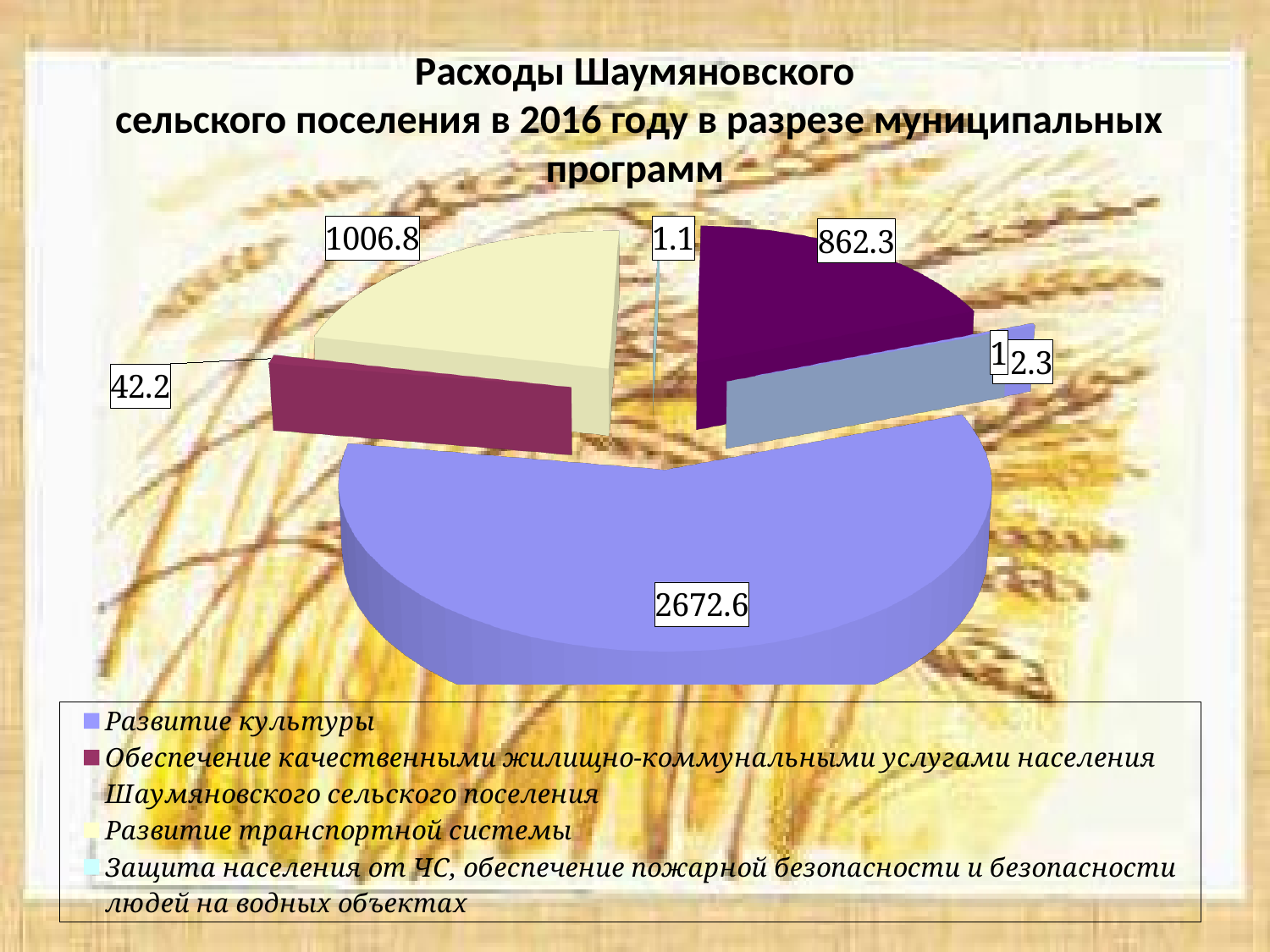
What year do the expenditures in the chart title refer to? 2016 How many entries does the legend list? 4 Which is larger: the value for Развитие транспортной системы or the value for Обеспечение качественными жилищно-коммунальными услугами населения? Развитие транспортной системы Which program has the largest slice of the pie? Развитие культуры What is the value for Развитие транспортной системы? 1006.8 What is the difference between the value for Развитие культуры and the value for Развитие транспортной системы? 1665.8 What kind of chart is shown on the slide? pie chart What is the difference between the value for Развитие транспортной системы and the value for Обеспечение качественными жилищно-коммунальными услугами населения? 964.6 What is the value for Развитие культуры? 2672.6 What is the value for Обеспечение качественными жилищно-коммунальными услугами населения Шаумяновского сельского поселения? 42.2 What is the value for Защита населения от ЧС, обеспечение пожарной безопасности и безопасности людей на водных объектах? 1.1